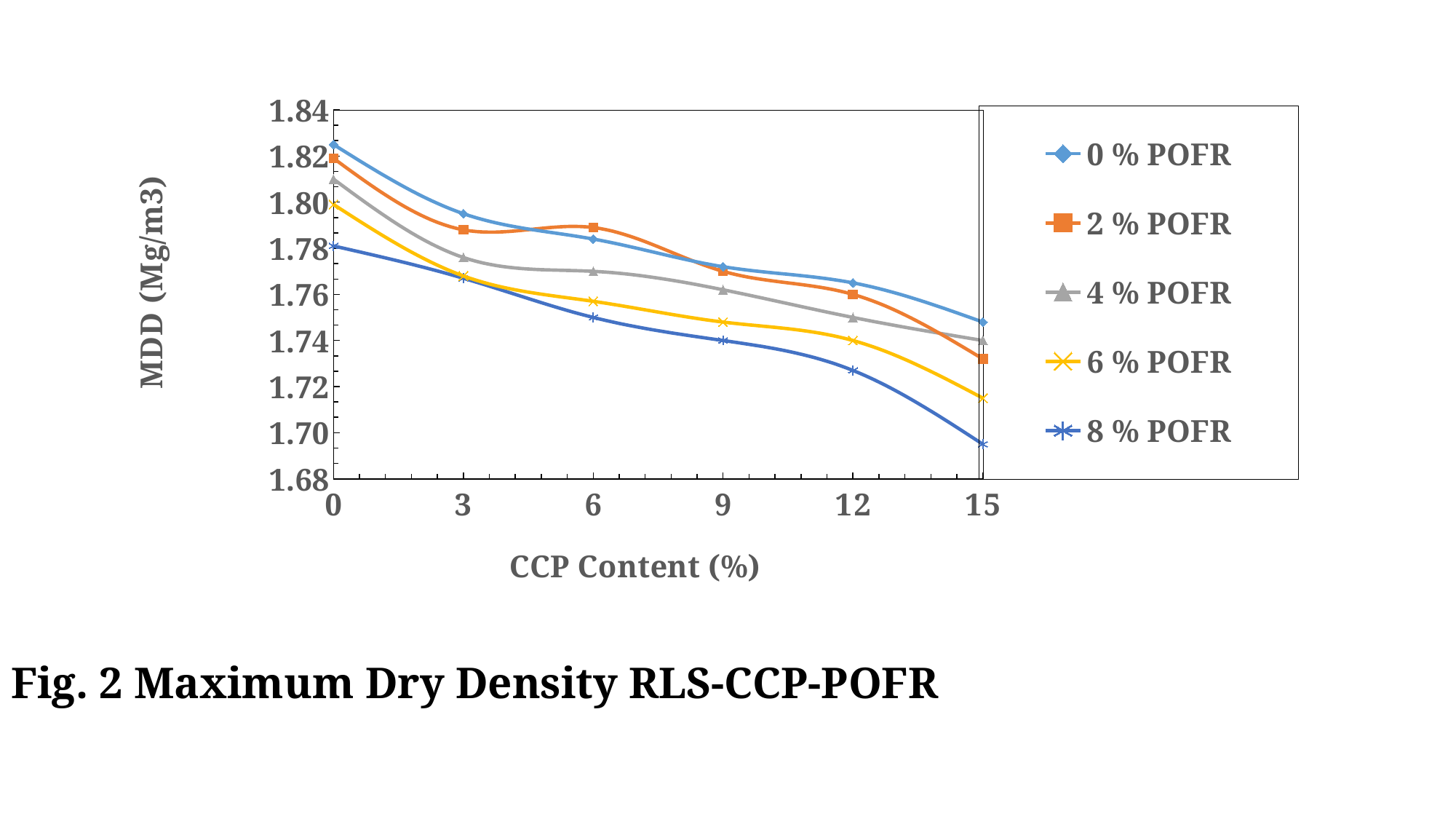
How many series does the legend list? 5 Which series has the lowest MDD at 15 % CCP content? 8 % POFR Is the MDD for 4 % POFR at 6 % CCP content greater or less than 1.76? greater Does the MDD for 0 % POFR rise or fall as CCP content increases from 0 to 15? fall What kind of chart is shown on the slide? line chart What is the title of the y axis? MDD (Mg/m3) How many CCP content values are plotted along the x axis? 6 What is the title of the x axis? CCP Content (%) Is the MDD for 0 % POFR at 0 % CCP content greater or less than 1.82? greater Is the MDD for 8 % POFR at 15 % CCP content greater or less than 1.70? less At 15 % CCP content, which is larger: the MDD for 0 % POFR or for 8 % POFR? 0 % POFR Which series has the highest MDD at 0 % CCP content? 0 % POFR